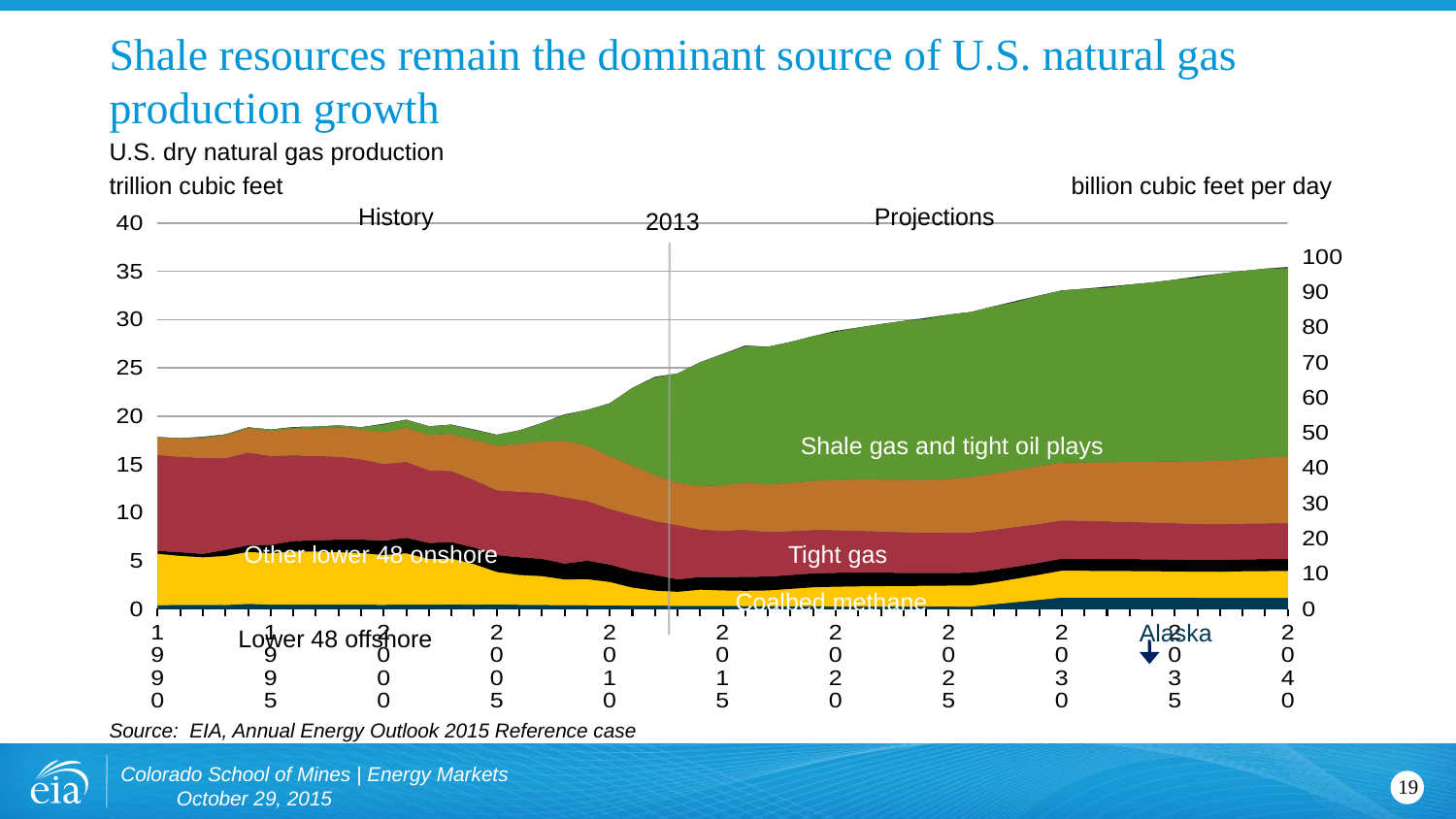
What is the title of the slide? Shale resources remain the dominant source of U.S. natural gas production growth How many production sources are labelled in the chart? 6 Is total U.S. dry natural gas production in 2030 greater or less than 30 trillion cubic feet? greater Is total U.S. dry natural gas production in 1990 greater or less than 20 trillion cubic feet? less Does production from shale gas and tight oil plays rise or fall between 2010 and 2040? Rises Does total U.S. dry natural gas production rise or fall from 2013 to 2040? Rises Which production source accounts for the largest share of U.S. dry natural gas production in the projection years? Shale gas and tight oil plays Which year marks the boundary between History and Projections in the chart? 2013 Is total U.S. dry natural gas production in 2020 greater or less than 25 trillion cubic feet? greater How many year labels are shown on the x axis? 11 What kind of chart is shown on the slide? Stacked area chart Does production from other lower 48 onshore rise or fall between 2005 and 2015? Falls